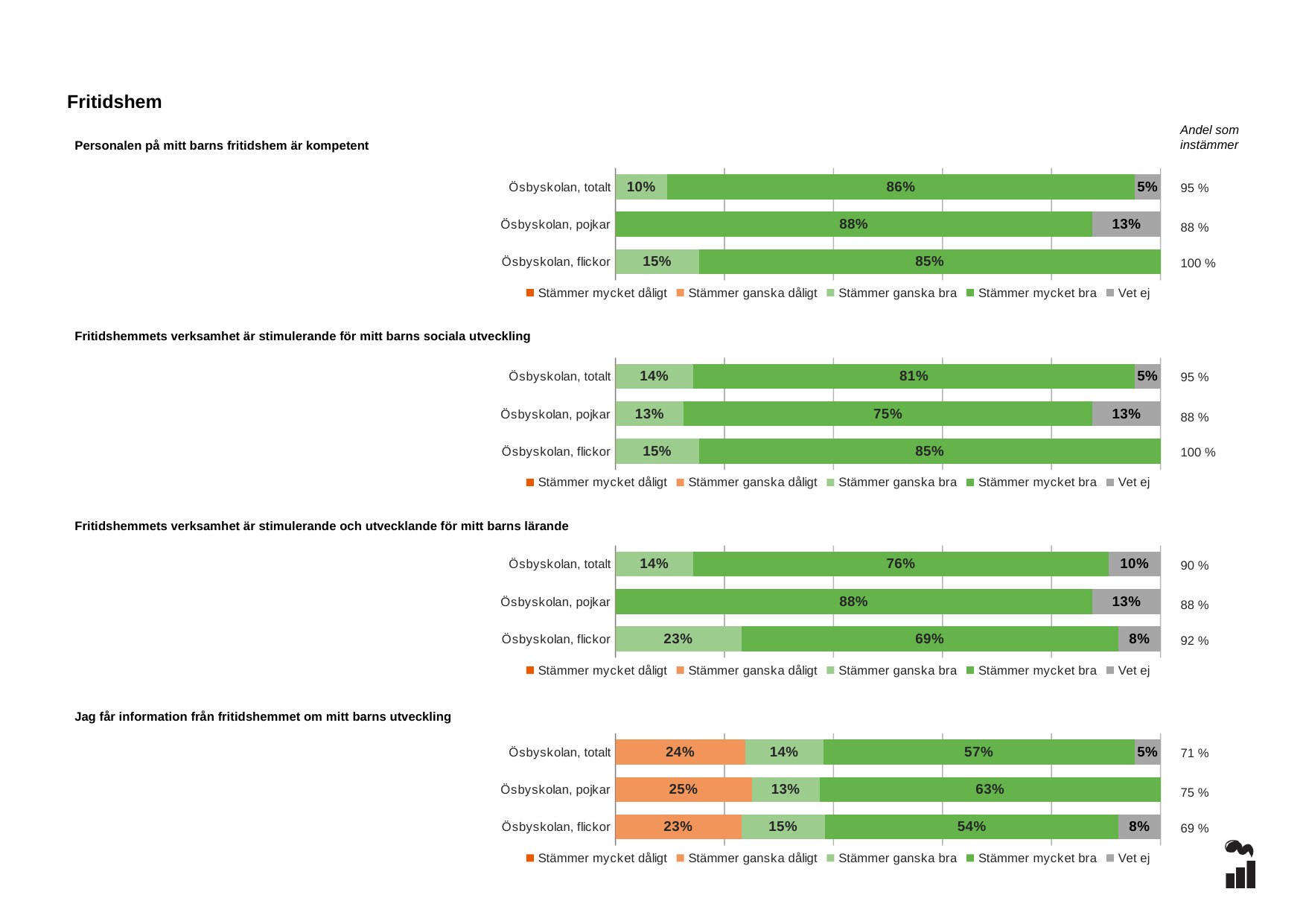
In the chart 'Fritidshemmets verksamhet är stimulerande och utvecklande för mitt barns lärande', what is the 'Stämmer ganska bra' value for Ösbyskolan, flickor? 23% In the chart 'Fritidshemmets verksamhet är stimulerande och utvecklande för mitt barns lärande', what is the difference between the 'Stämmer mycket bra' values for Ösbyskolan, pojkar and Ösbyskolan, flickor? 19% What kind of chart is used for 'Fritidshemmets verksamhet är stimulerande för mitt barns sociala utveckling'? Stacked bar chart In the chart 'Fritidshemmets verksamhet är stimulerande för mitt barns sociala utveckling', what is the 'Stämmer mycket bra' value for Ösbyskolan, pojkar? 75% In the chart 'Personalen på mitt barns fritidshem är kompetent', what is the 'Stämmer mycket bra' value for Ösbyskolan, totalt? 86% In the chart 'Fritidshemmets verksamhet är stimulerande för mitt barns sociala utveckling', which category has the highest 'Stämmer mycket bra' value? Ösbyskolan, flickor How many categories are shown in the chart 'Personalen på mitt barns fritidshem är kompetent'? 3 In the chart 'Jag får information från fritidshemmet om mitt barns utveckling', which category has the lowest 'Stämmer mycket bra' value? Ösbyskolan, flickor In the chart 'Jag får information från fritidshemmet om mitt barns utveckling', is the 'Stämmer mycket bra' value for Ösbyskolan, totalt larger or smaller than for Ösbyskolan, pojkar? smaller In the chart 'Jag får information från fritidshemmet om mitt barns utveckling', what is the 'Stämmer ganska dåligt' value for Ösbyskolan, pojkar? 25% How many series does the legend of the chart 'Jag får information från fritidshemmet om mitt barns utveckling' list? 5 In the chart 'Personalen på mitt barns fritidshem är kompetent', what is the 'Vet ej' value for Ösbyskolan, pojkar? 13%